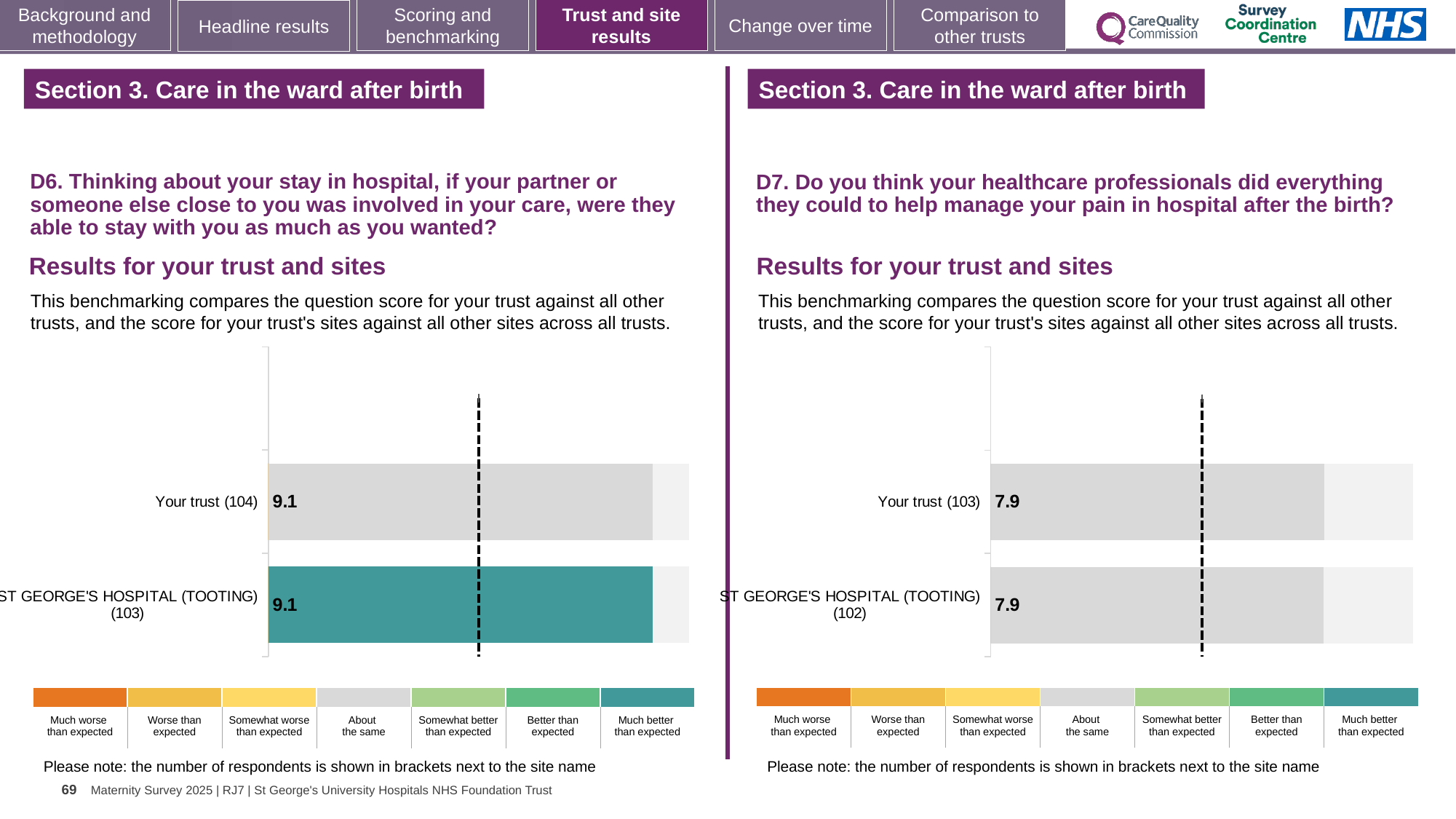
In the left chart (D6), what is the difference between the score for Your trust and the score for St George's Hospital (Tooting)? 0 How many bars are plotted in the left chart (D6)? 2 How many bars are plotted in the right chart (D7)? 2 In the right chart (D7), what is the score for St George's Hospital (Tooting)? 7.9 In the left chart (D6), how many respondents are shown in brackets for St George's Hospital (Tooting)? 103 In the left chart (D6), which benchmark category does the colour of the St George's Hospital (Tooting) bar correspond to in the legend? Much better than expected In the left chart (D6), what is the score for Your trust? 9.1 In the right chart (D7), what is the difference between the score for Your trust and the score for St George's Hospital (Tooting)? 0 In the right chart (D7), what is the score for Your trust? 7.9 In the left chart (D6), what is the score for St George's Hospital (Tooting)? 9.1 What kind of chart is used for the D6 results on the left? Bar chart